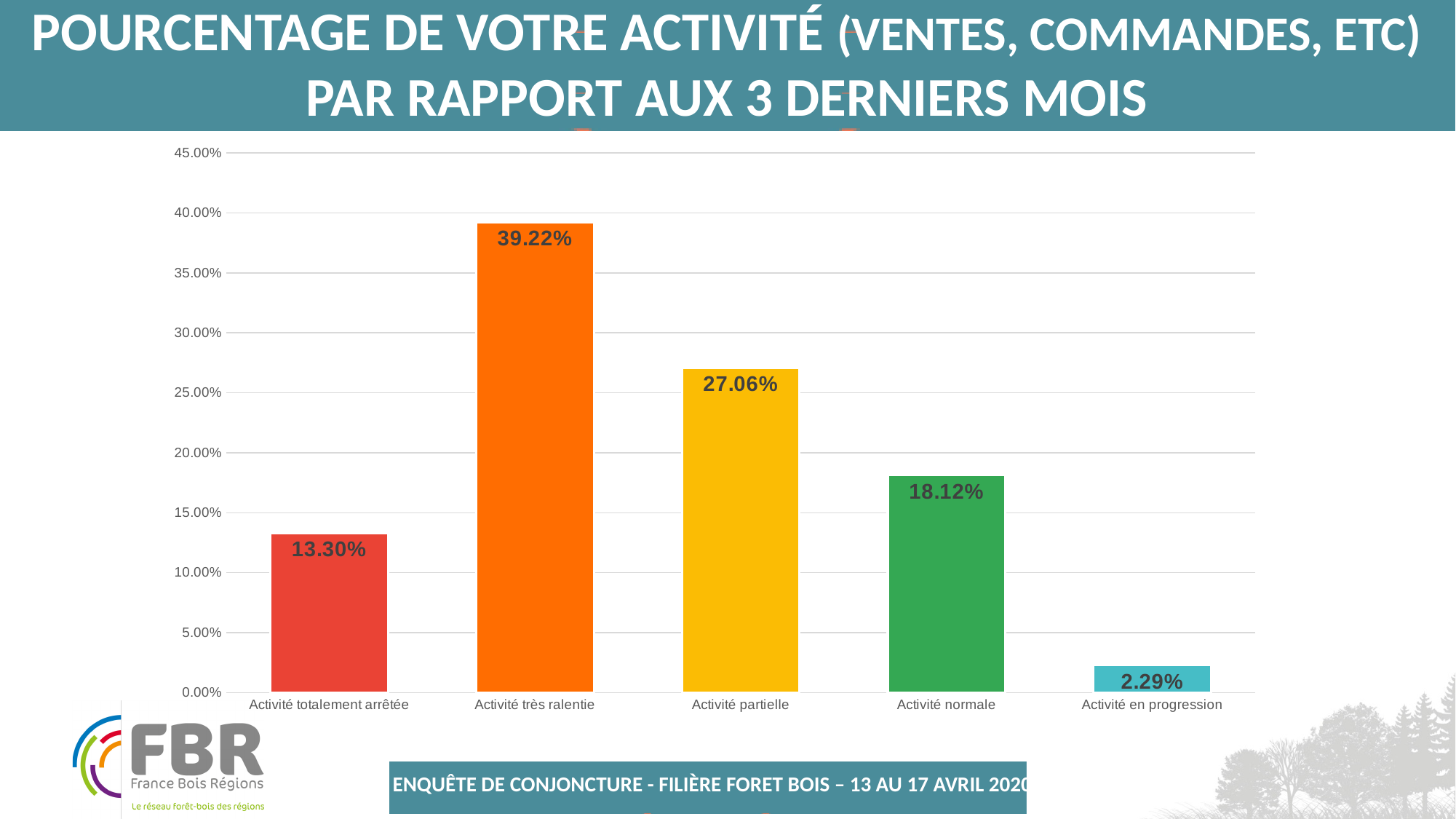
What is the difference between the values for "Activité très ralentie" and "Activité partielle"? 12.16% Which is larger, the value for "Activité partielle" or the value for "Activité normale"? Activité partielle Is the value for "Activité partielle" greater or less than 25.00%? greater How many categories are shown on the x axis? 5 What kind of chart is shown on the slide? bar chart What is the value for "Activité normale"? 18.12% Which category has the lowest value? Activité en progression Which category has the highest value? Activité très ralentie What colour is the bar for "Activité très ralentie"? orange What is the value for "Activité totalement arrêtée"? 13.30% What is the value for "Activité très ralentie"? 39.22% What is the value for "Activité en progression"? 2.29%